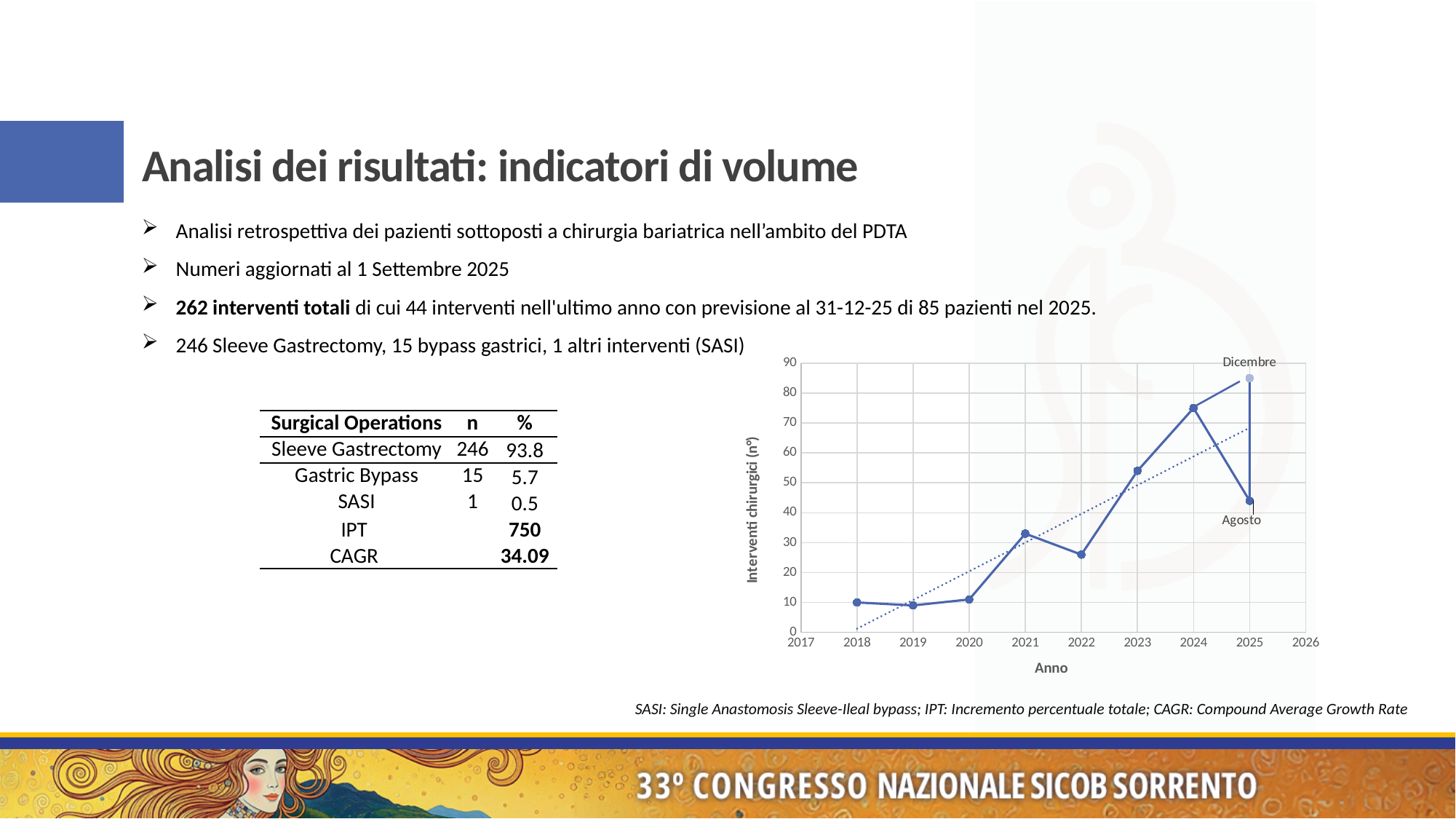
Is the value for 2023 greater or less than 50? greater Is the value for 2022 greater or less than 30? less Is the value for 2020 greater or less than 20? less Which two labels annotate the two data points plotted at 2025? Agosto and Dicembre Which is larger, the value for 2021 or the value for 2022? 2021 Do the values rise or fall from 2022 to 2024? rise Excluding the Dicembre 2025 point, which year has the highest value? 2024 What kind of chart is shown on the slide? line chart What is the title of the x axis of the chart? Anno